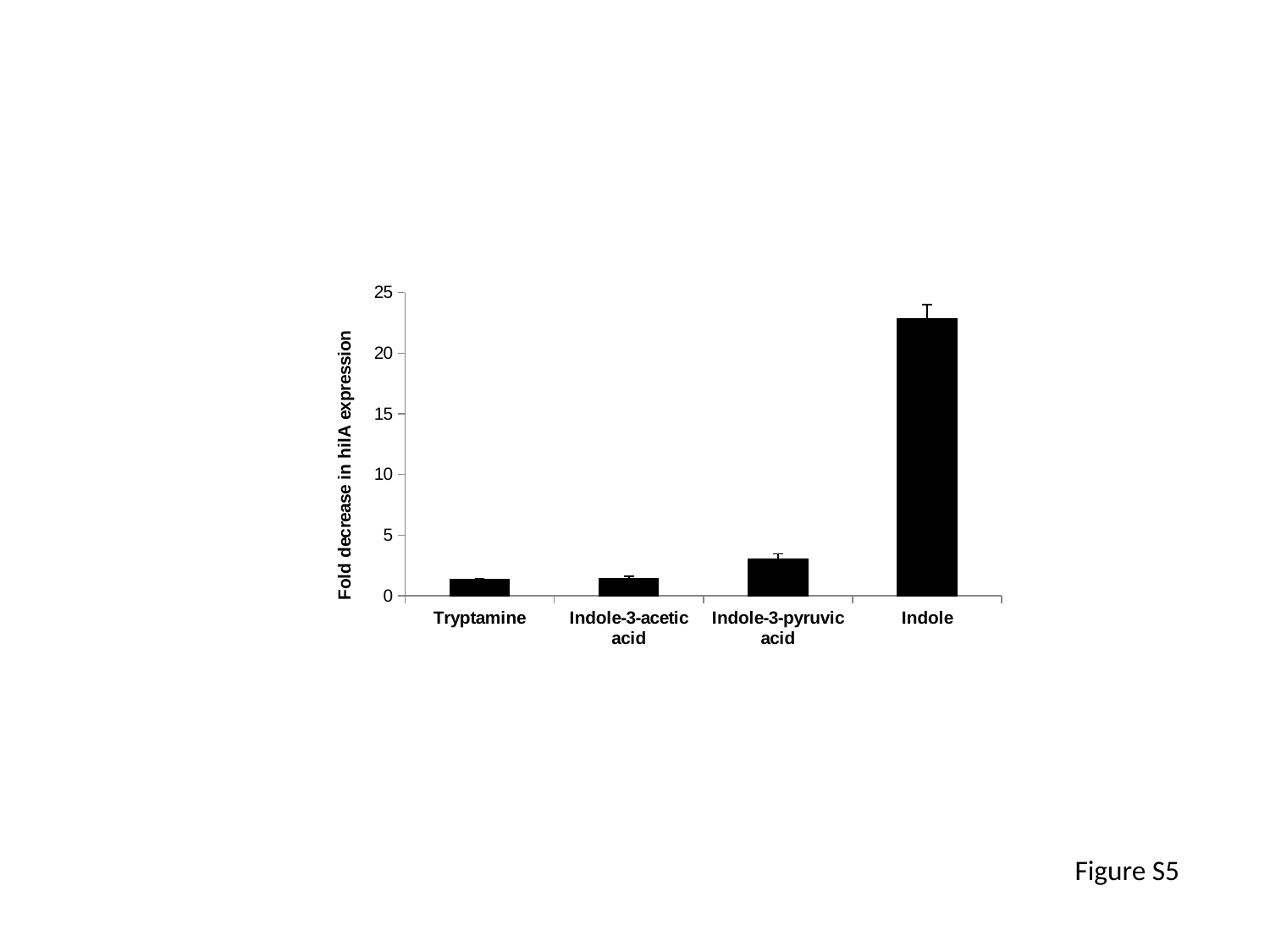
Which is larger, the value for Indole or the value for Indole-3-pyruvic acid? Indole How many categories are plotted on the x axis? 4 Which is larger, the value for Indole-3-pyruvic acid or the value for Tryptamine? Indole-3-pyruvic acid What figure label appears on the slide? Figure S5 Is the value for Tryptamine greater or less than 5? less What kind of chart is shown on the slide? bar chart Is the value for Indole greater or less than 20? greater Which category has the highest fold decrease in hilA expression? Indole What is the label of the y axis? Fold decrease in hilA expression Is the value for Indole greater or less than 25? less